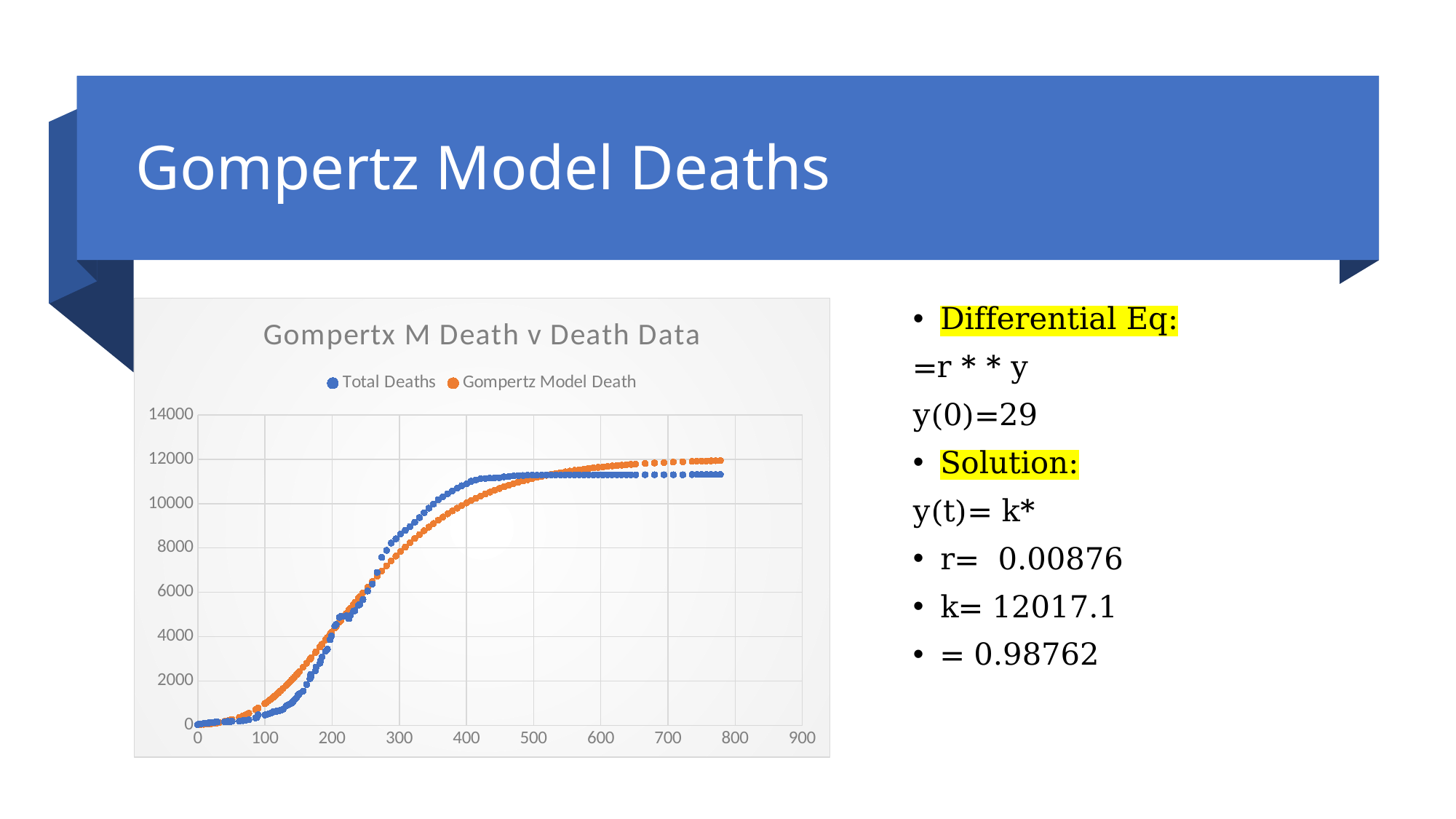
Is the Gompertz Model Death value at x = 750 greater or less than 14000? less Which series is plotted in orange? Gompertz Model Death Is the Total Deaths value at x = 700 greater or less than 10000? greater What is the title of the chart? Gompertx M Death v Death Data Is the Total Deaths value at x = 300 greater or less than 8000? greater At x = 700, which series has the higher value, Total Deaths or Gompertz Model Death? Gompertz Model Death Do the Total Deaths values rise or fall as the x axis increases from 0 to 400? Rise At x = 150, which series has the higher value, Total Deaths or Gompertz Model Death? Gompertz Model Death How many series does the chart legend list? 2 At x = 300, which series has the higher value, Total Deaths or Gompertz Model Death? Total Deaths What kind of chart is shown on the slide? Scatter chart